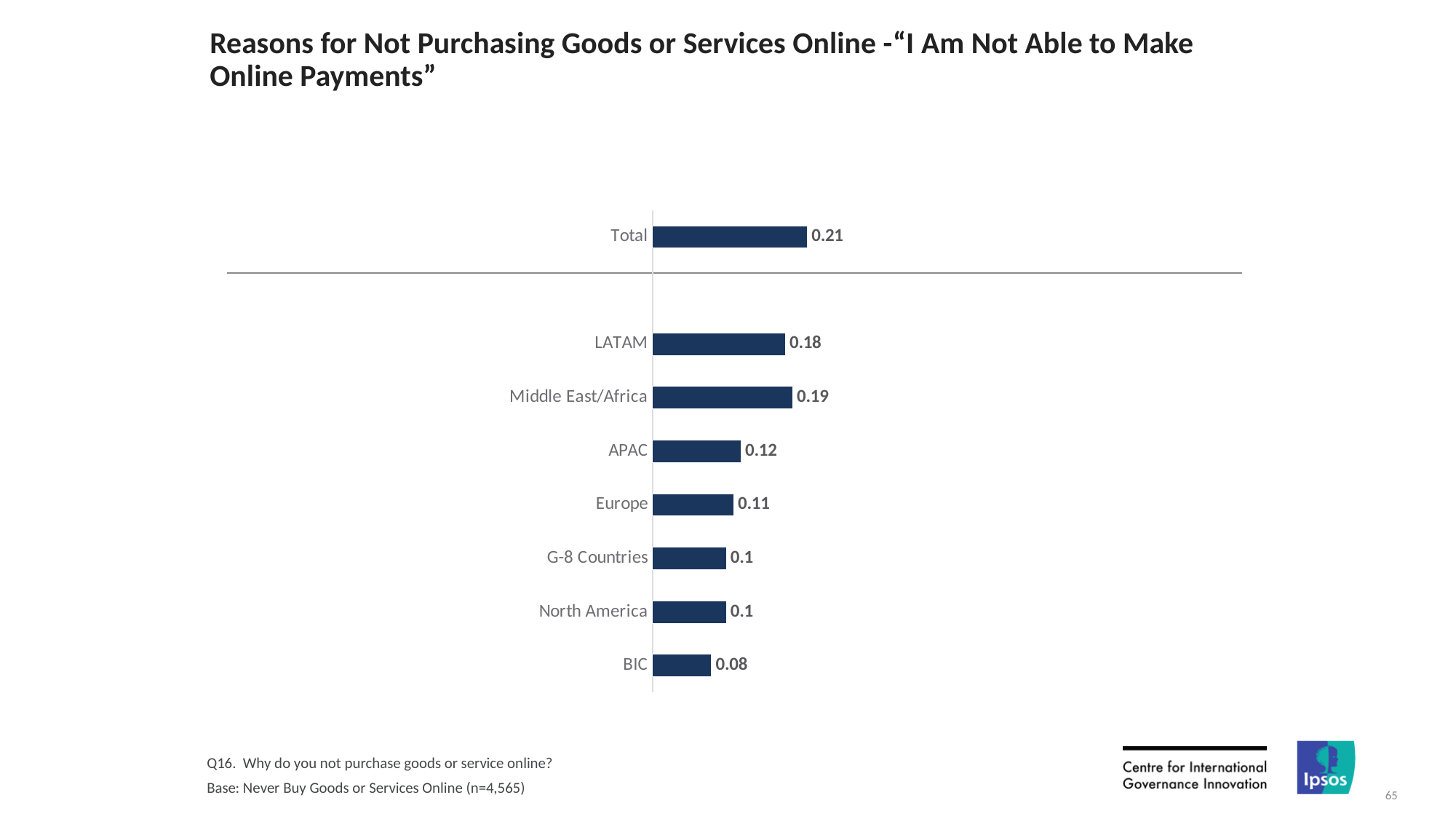
What is the difference between the values for LATAM and Europe? 0.07 Which is larger, the value for LATAM or the value for APAC? LATAM What is the value for APAC? 0.12 What is the value for Total? 0.21 Which region has the highest value? Middle East/Africa What kind of chart is shown on the slide? Bar chart Which two regions share the same value of 0.1? G-8 Countries and North America Which region has the lowest value? BIC What is the difference between the values for Total and BIC? 0.13 How many bars are plotted on the chart, including Total? 8 What is the value for BIC? 0.08 What is the value for Middle East/Africa? 0.19